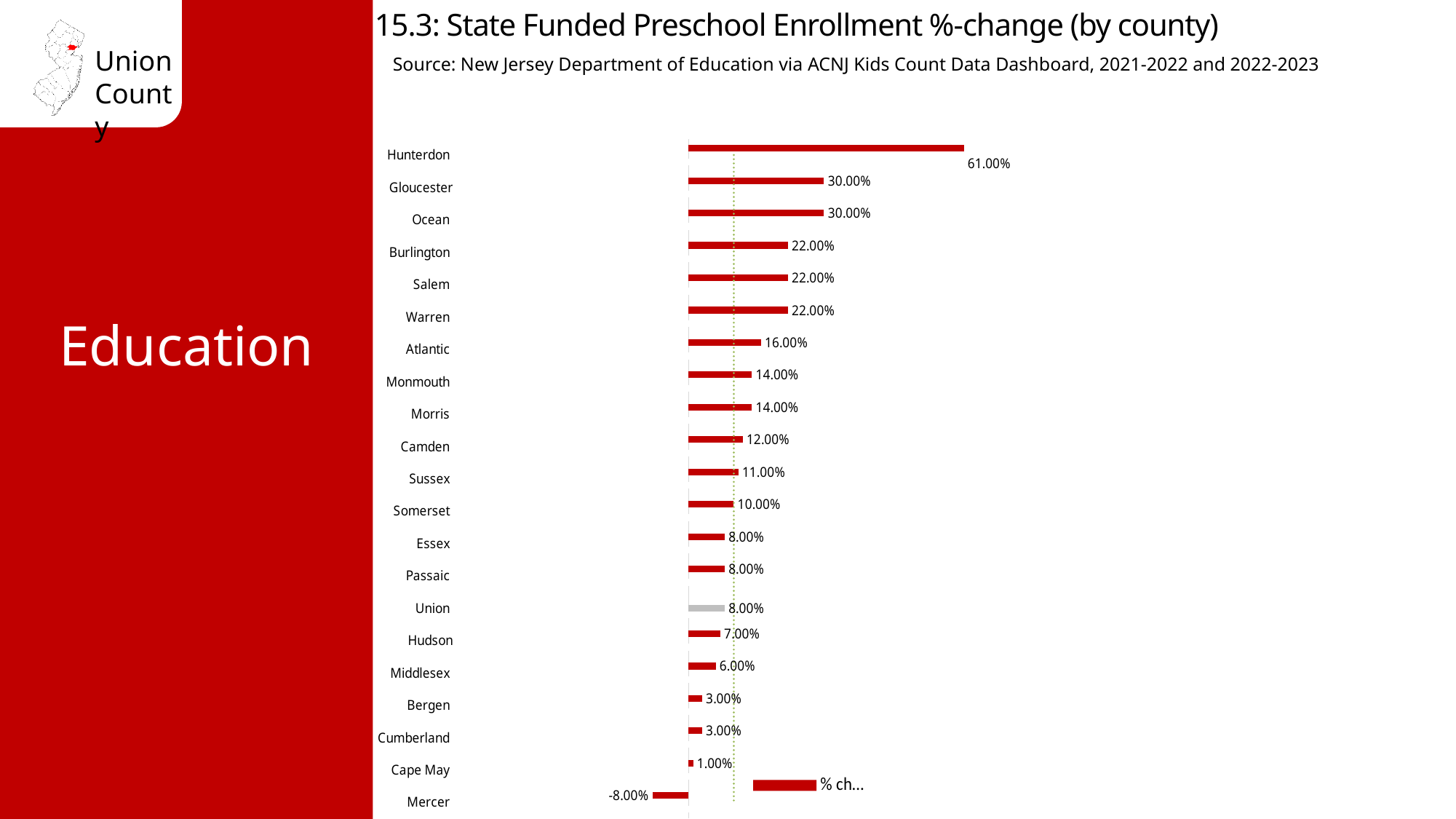
Which county has the highest %-change? Hunterdon Which county has the lowest %-change? Mercer What is the difference between the values for Hunterdon and Gloucester? 31.00% How many counties are shown in the chart? 21 Which county's bar is drawn in grey rather than red? Union What kind of chart is shown on the slide? Bar chart What is the state funded preschool enrollment %-change for Hunterdon? 61.00% What is the value shown for Cape May? 1.00% What is the value shown for Mercer? -8.00% What is the value shown for Union county? 8.00% What is the difference between the values for Union and Mercer? 16.00% Which has a larger %-change, Atlantic or Camden? Atlantic